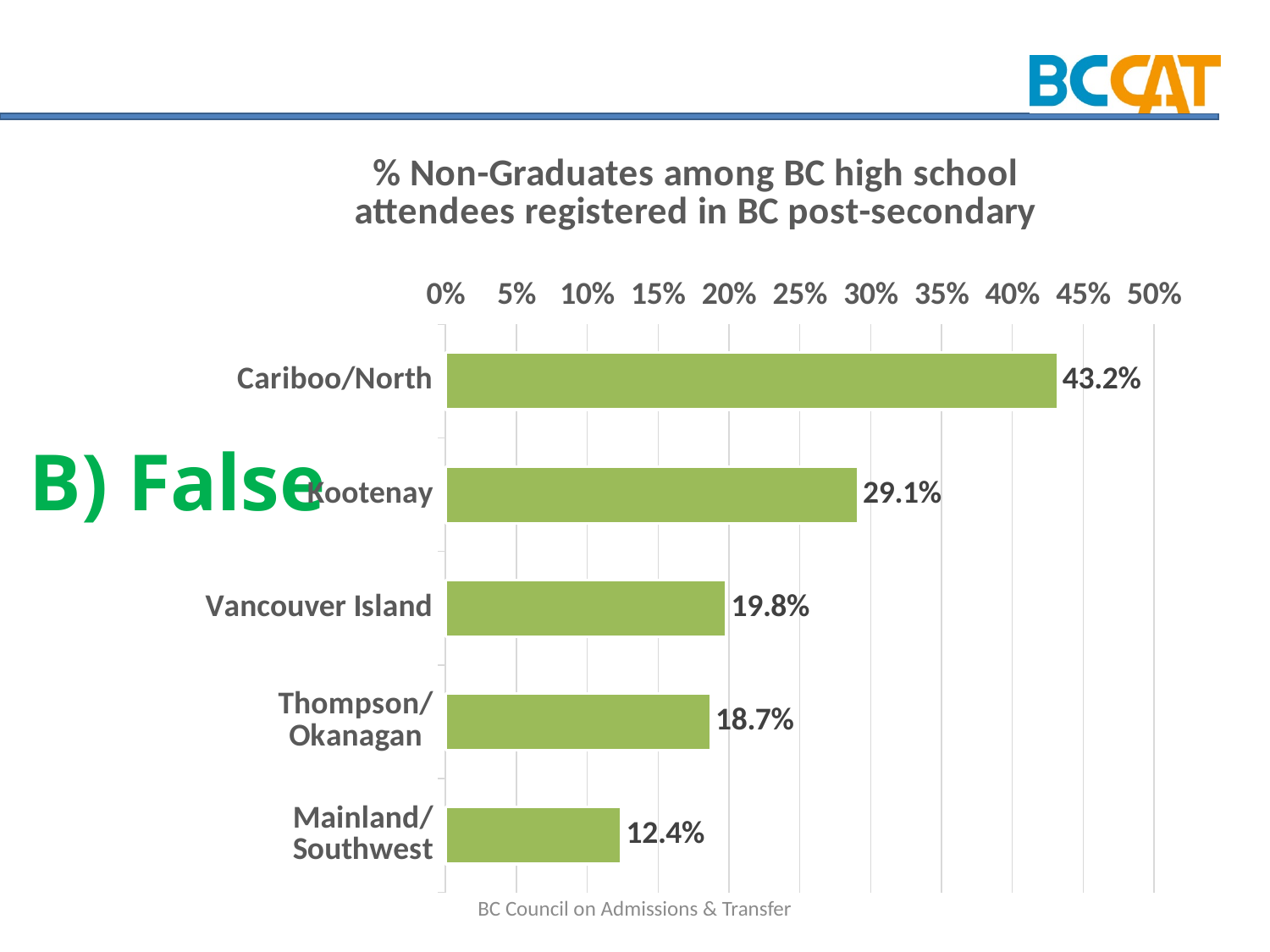
What is the difference between the values for Cariboo/North and Kootenay? 14.1% What is the value for Kootenay? 29.1% Which region has the lowest percentage of non-graduates? Mainland/Southwest Which region has the highest percentage of non-graduates? Cariboo/North What is the title of the chart? % Non-Graduates among BC high school attendees registered in BC post-secondary What kind of chart is shown on the slide? Bar chart Which is larger, the value for Vancouver Island or the value for Mainland/Southwest? Vancouver Island What is the value for Mainland/Southwest? 12.4% What is the value for Thompson/Okanagan? 18.7% How many regions are shown in the chart? 5 What is the value for Cariboo/North? 43.2% What is the value for Vancouver Island? 19.8%